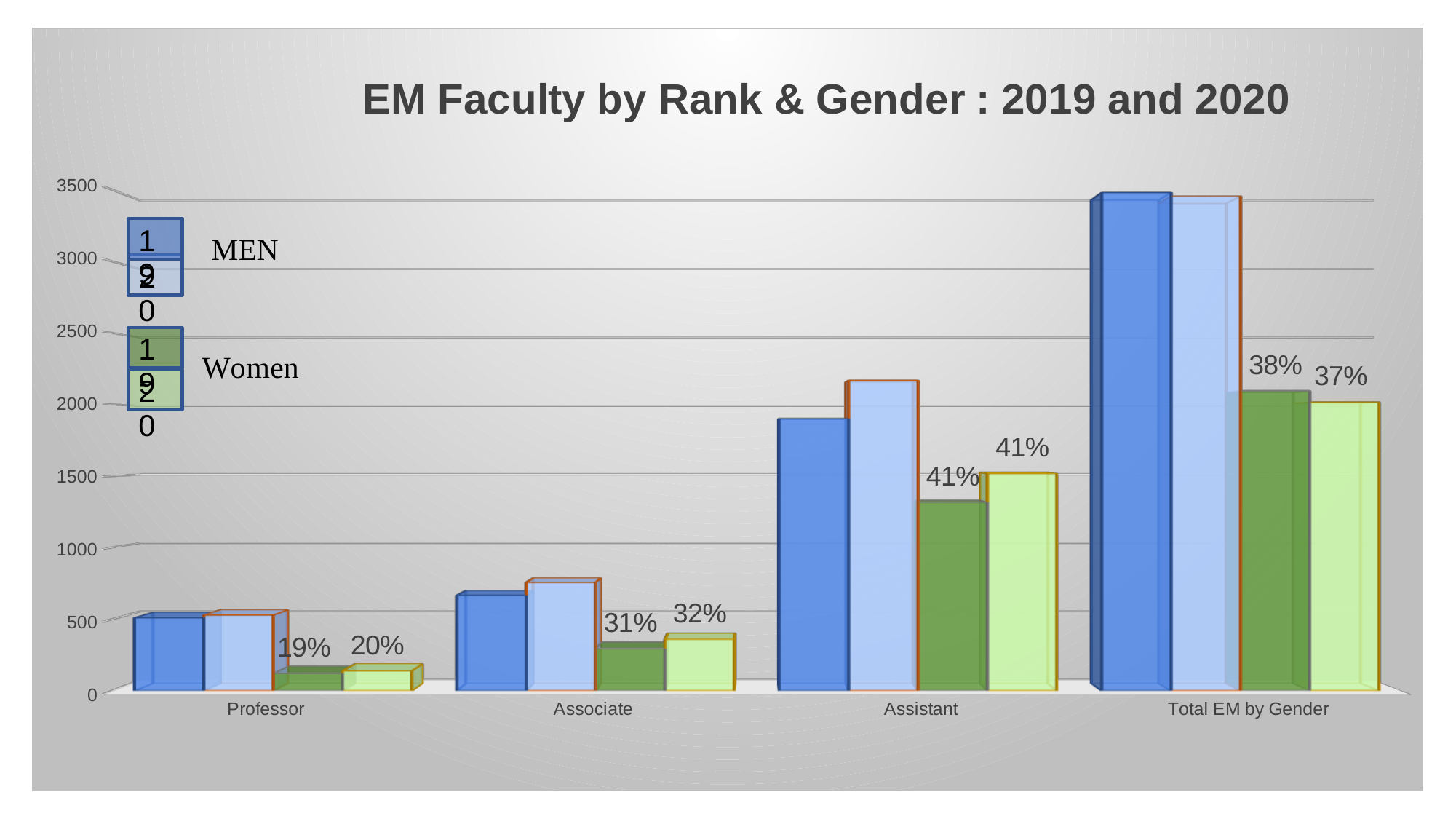
Is the value of the dark blue (Men 2019) bar for Total EM by Gender greater or less than 3000? greater What percentage label is shown above the dark green (Women 2019) bar for Associate? 31% What is the title of the chart? EM Faculty by Rank & Gender : 2019 and 2020 For Assistant, which is taller: the dark blue (Men 2019) bar or the light blue (Men 2020) bar? Men 2020 What percentage label is shown above the dark green (Women 2019) bar for Assistant? 41% Is the value of the light blue (Men 2020) bar for Associate greater or less than 1000? less What percentage label is shown above the light green (Women 2020) bar for Total EM by Gender? 37% What percentage label is shown above the light green (Women 2020) bar for Professor? 20% Which category has the tallest bar in the chart? Total EM by Gender Which category has the shortest bar in the chart? Professor What kind of chart is shown on the slide? bar chart How many categories are shown along the x axis? 4